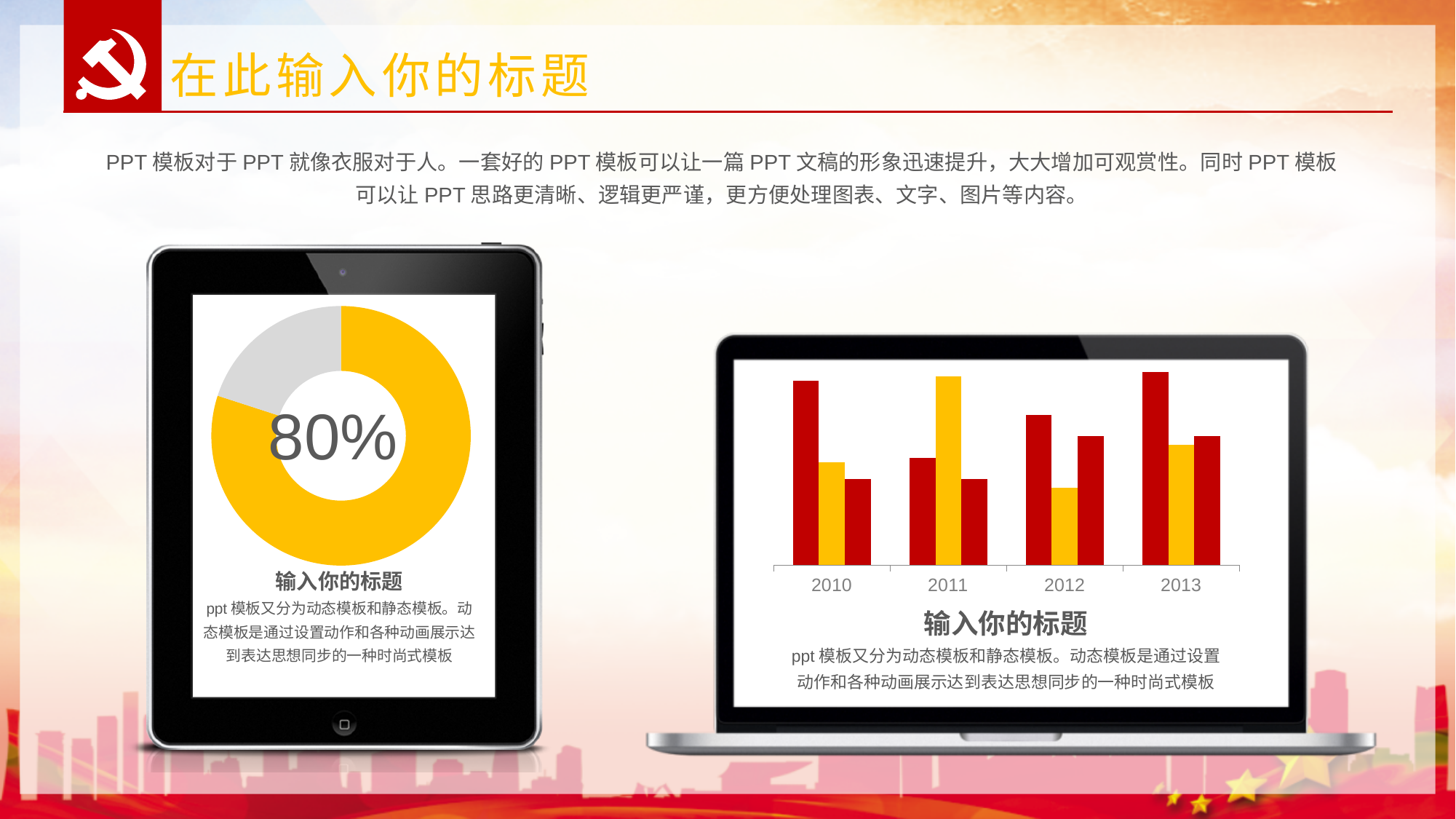
On the donut chart on the tablet, what percentage is shown in the centre? 80% On the bar chart on the laptop, which year has the shortest bright red (first) bar? 2011 What kind of chart is shown on the laptop on the right? Bar chart On the donut chart on the tablet, what share of the ring does the yellow segment represent? 80% On the bar chart on the laptop, how many bars are there in each year group? 3 On the bar chart on the laptop, in 2010 is the bright red bar or the yellow bar taller? Bright red bar On the bar chart on the laptop, which year has the tallest dark red (third) bar? 2012 and 2013 (tied) On the bar chart on the laptop, which year has the tallest yellow bar? 2011 On the bar chart on the laptop, which year has the shortest yellow bar? 2012 On the bar chart on the laptop, in 2011 is the yellow bar or the bright red bar taller? Yellow bar On the bar chart on the laptop, how many years are shown on the x axis? 4 What kind of chart is shown on the tablet on the left? Donut (pie) chart